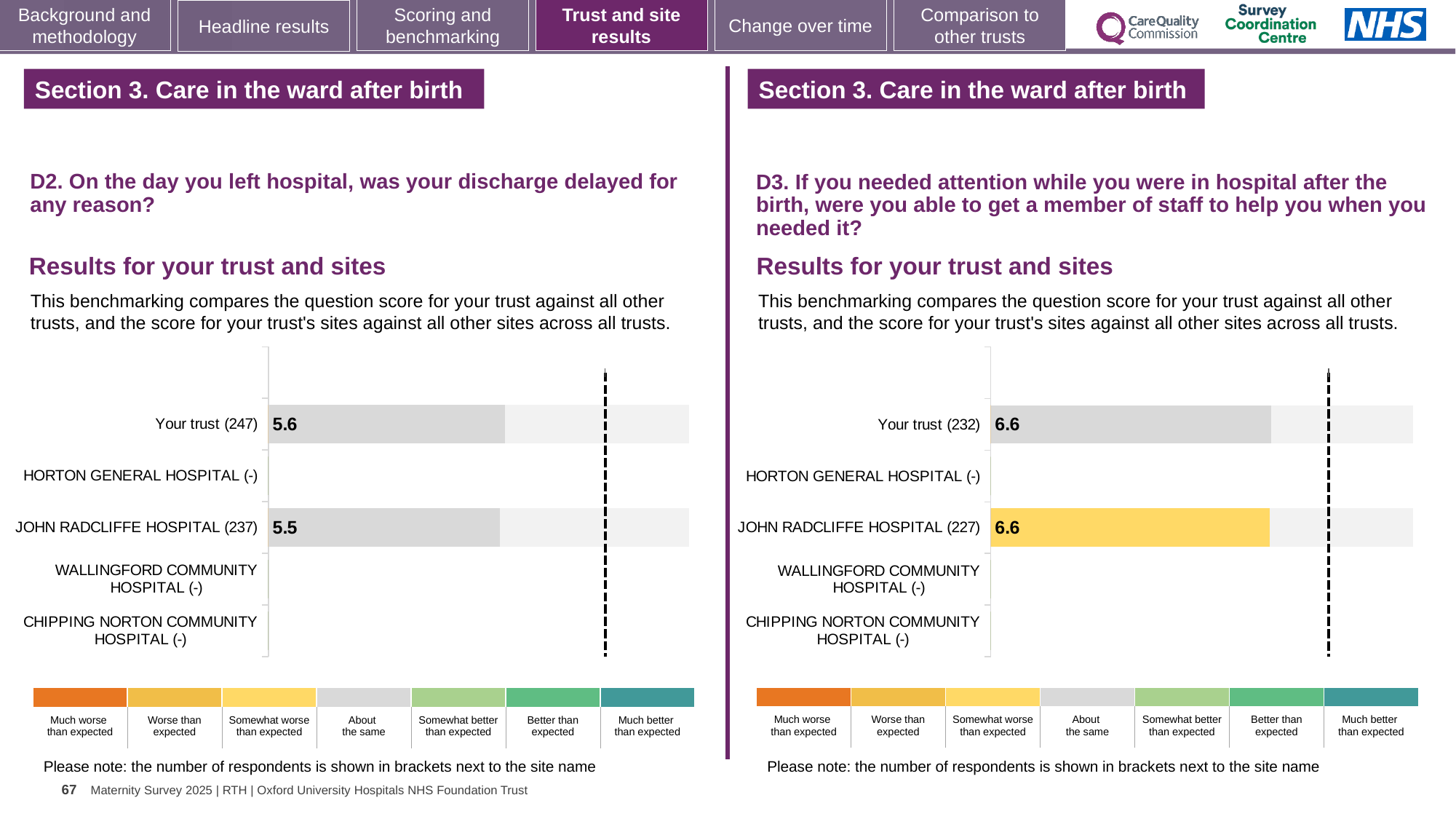
In the D3 chart on the right, what is the score for John Radcliffe Hospital? 6.6 In the D3 chart on the right, what colour is the bar for John Radcliffe Hospital? Yellow In the D3 chart on the right, how many respondents are shown in brackets for John Radcliffe Hospital? 227 In the D2 chart on the left, what is the score for Your trust? 5.6 In the D2 chart on the left, what is the difference between the score for Your trust and the score for John Radcliffe Hospital? 0.1 In the D2 chart on the left, what is the score for John Radcliffe Hospital? 5.5 In the D2 chart on the left, which benchmark category does the grey colour of the Your trust bar correspond to in the legend? About the same How many site or trust categories are listed on the y axis of the D2 chart on the left? 5 In the D2 chart on the left, how many respondents are shown in brackets for Your trust? 247 In the D3 chart on the right, how many respondents are shown in brackets for Your trust? 232 What kind of chart is the D3 chart on the right? Bar chart In the D3 chart on the right, what is the score for Your trust? 6.6